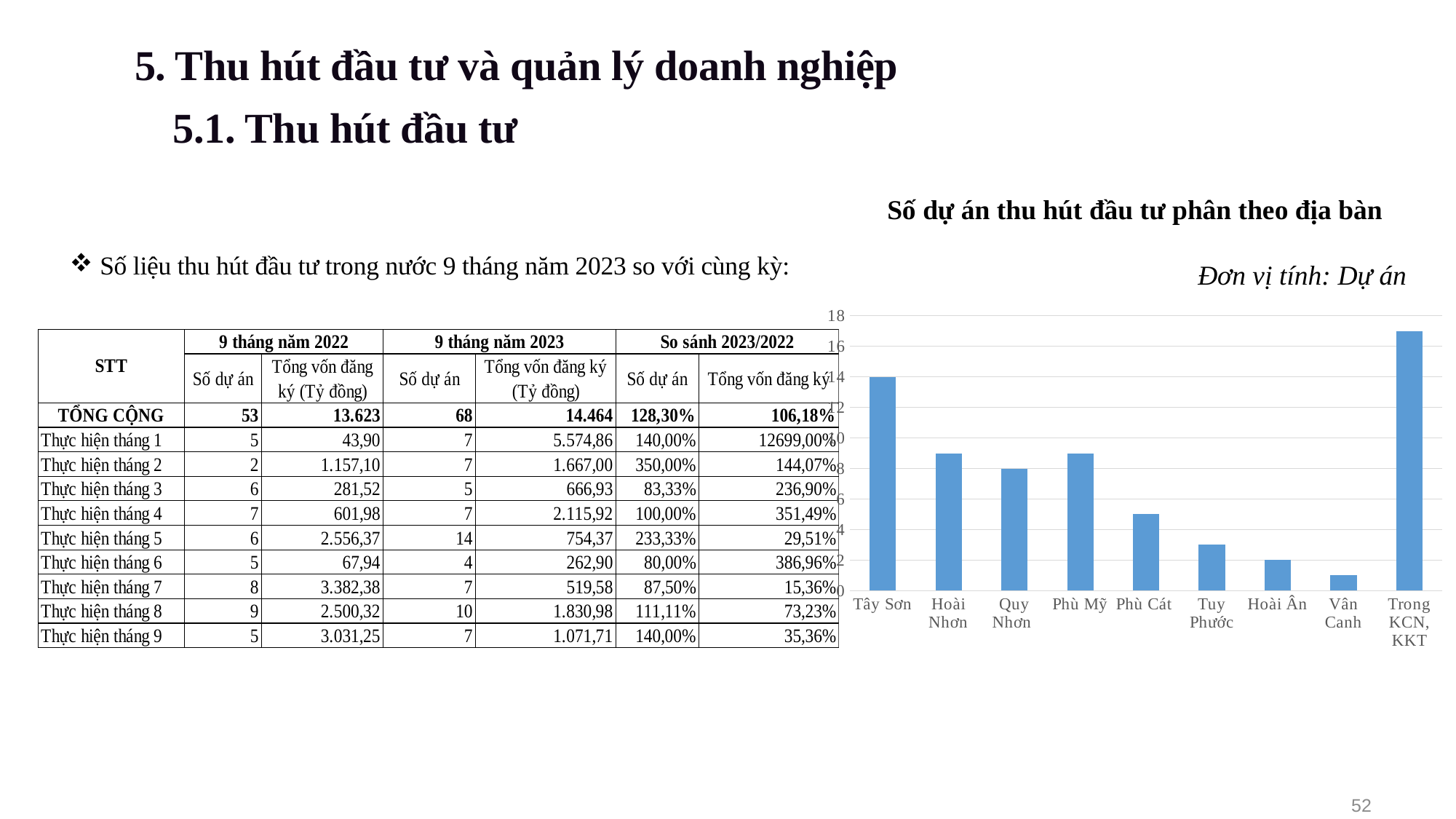
Is the value for Trong KCN, KKT greater or less than 16? greater How many categories (localities) are shown on the x axis of the chart? 9 What kind of chart is shown on the slide? bar chart What is the value for Hoài Ân in the chart? 2 Which category has the lowest bar in the chart? Vân Canh Is the value for Tuy Phước greater or less than 4? less What is the difference between the values for Tây Sơn and Quy Nhơn in the chart? 6 What is the title of the chart on the slide? Số dự án thu hút đầu tư phân theo địa bàn Which category has the highest bar in the chart? Trong KCN, KKT What is the value for Quy Nhơn in the chart? 8 What is the value for Tây Sơn in the chart? 14 Which is larger in the chart, the value for Tây Sơn or the value for Phù Cát? Tây Sơn